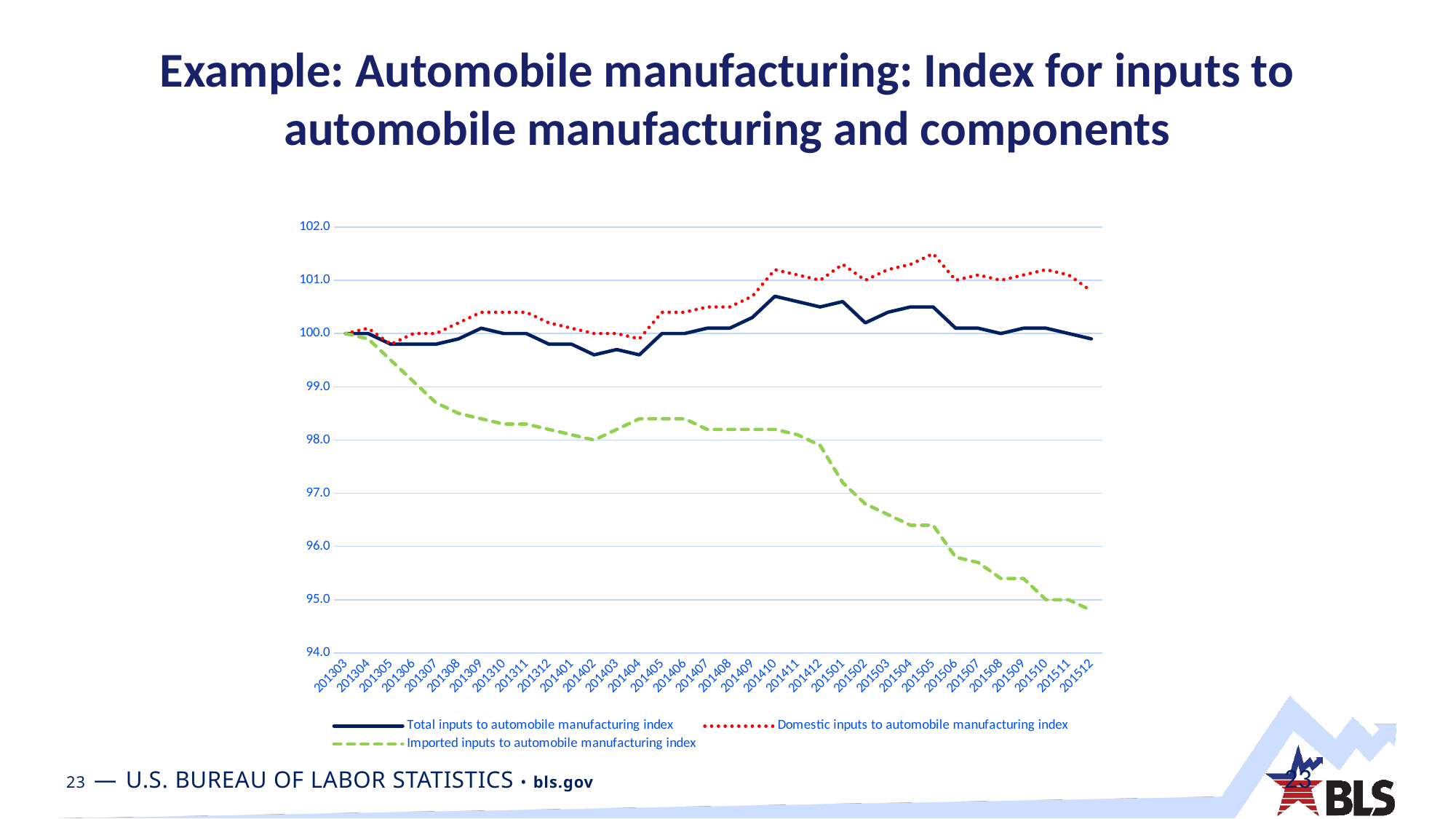
Does the Imported inputs to automobile manufacturing index rise or fall from 201303 to 201512? fall At 201512, which is larger: the Domestic inputs index or the Imported inputs index? Domestic inputs to automobile manufacturing index How many time points are plotted along the x axis? 34 Which series is drawn as a red dotted line? Domestic inputs to automobile manufacturing index What is the value of the Total inputs to automobile manufacturing index at 201303? 100.0 How many series does the legend list? 3 Is the value of the Total inputs to automobile manufacturing index at 201402 greater or less than 100.0? less What kind of chart is shown on the slide? line chart Is the value of the Imported inputs to automobile manufacturing index at 201501 greater or less than 98.0? less Is the value of the Domestic inputs to automobile manufacturing index at 201505 greater or less than 101.0? greater Which series has the lowest value at 201512? Imported inputs to automobile manufacturing index